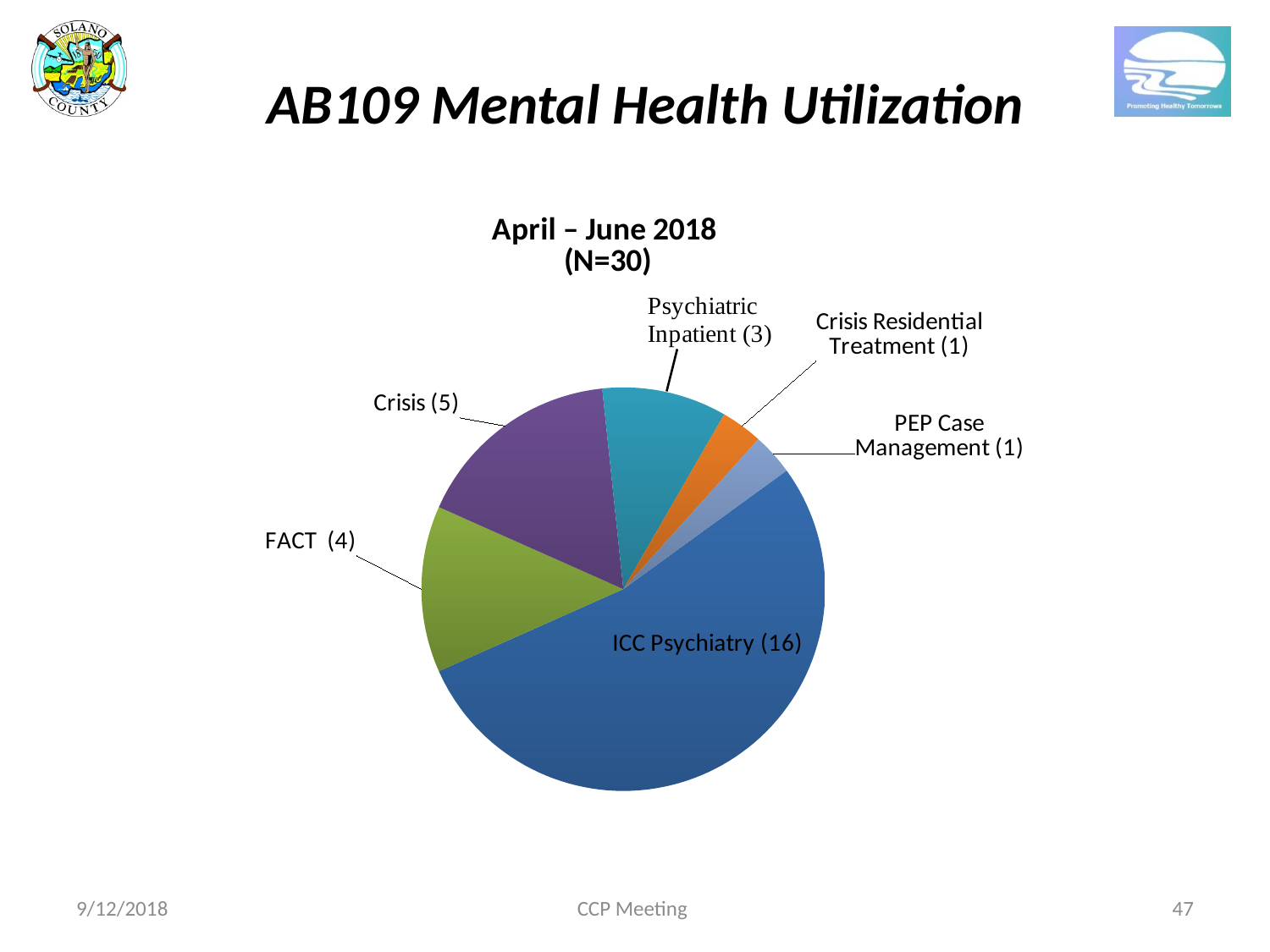
How many slices does the pie chart have? 6 Which is larger, Crisis or FACT? Crisis What is the value for PEP Case Management? 1 Which category has the largest slice? ICC Psychiatry What is the value for Psychiatric Inpatient? 3 What period does the chart title say the data covers? April – June 2018 What is the difference between the values for ICC Psychiatry and FACT? 12 What is the difference between the values for Crisis and Psychiatric Inpatient? 2 What is the value for ICC Psychiatry? 16 What is the total N shown in the chart title? 30 What is the value for Crisis? 5 What kind of chart is shown on the slide? pie chart